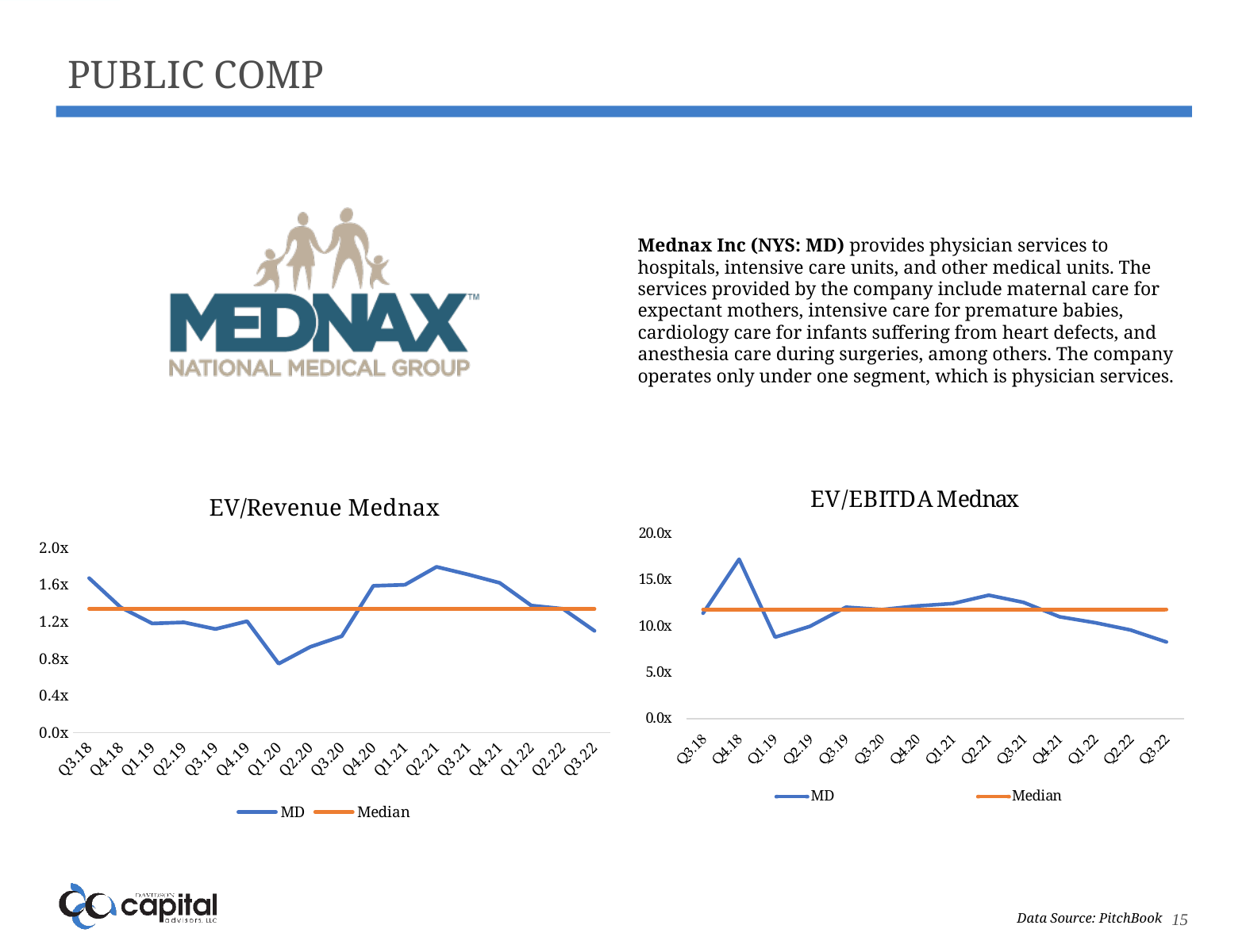
In the EV/Revenue Mednax chart, which is larger, the MD value for Q3.18 or for Q1.20? Q3.18 In the EV/Revenue Mednax chart, which quarter has the lowest MD value? Q1.20 In the EV/EBITDA Mednax chart, does the MD line rise or fall from Q2.21 to Q3.22? fall In the EV/EBITDA Mednax chart, which quarter has the highest MD value? Q4.18 In the EV/EBITDA Mednax chart, is the MD value for Q4.18 greater or less than 15.0x? greater In the EV/Revenue Mednax chart, which quarter has the highest MD value? Q2.21 What are the two series named in the legend of the EV/Revenue Mednax chart? MD and Median In the EV/Revenue Mednax chart, is the MD value for Q1.20 greater or less than 0.8x? less How many quarters are plotted along the x axis of the EV/Revenue Mednax chart? 17 How many series does the legend of the EV/EBITDA Mednax chart list? 2 What kind of chart is the EV/Revenue Mednax chart? line chart In the EV/EBITDA Mednax chart, is the MD value for Q3.22 greater or less than 10.0x? less